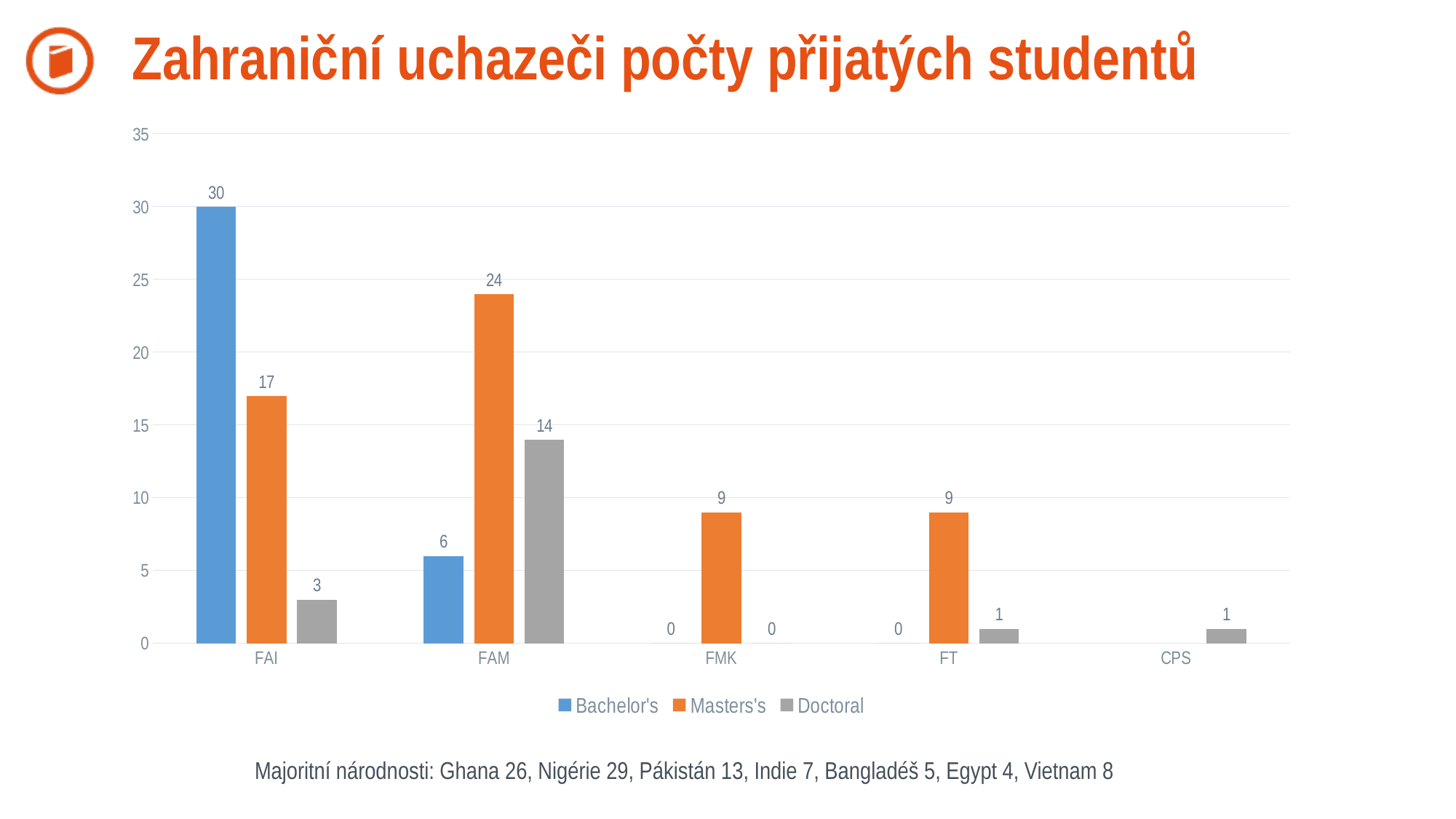
Which category has the highest Bachelor's value? FAI How many categories are shown on the x axis? 5 What is the Masters's value for FAM? 24 What is the Bachelor's value for FAI? 30 What is the Doctoral value for FAM? 14 What is the Masters's value for FT? 9 What kind of chart is shown on the slide? Bar chart What is the difference between the Masters's values for FAM and FAI? 7 Which is larger, the Doctoral value for FAI or the Doctoral value for FAM? FAM What is the title of the slide? Zahraniční uchazeči počty přijatých studentů How many series does the legend list? 3